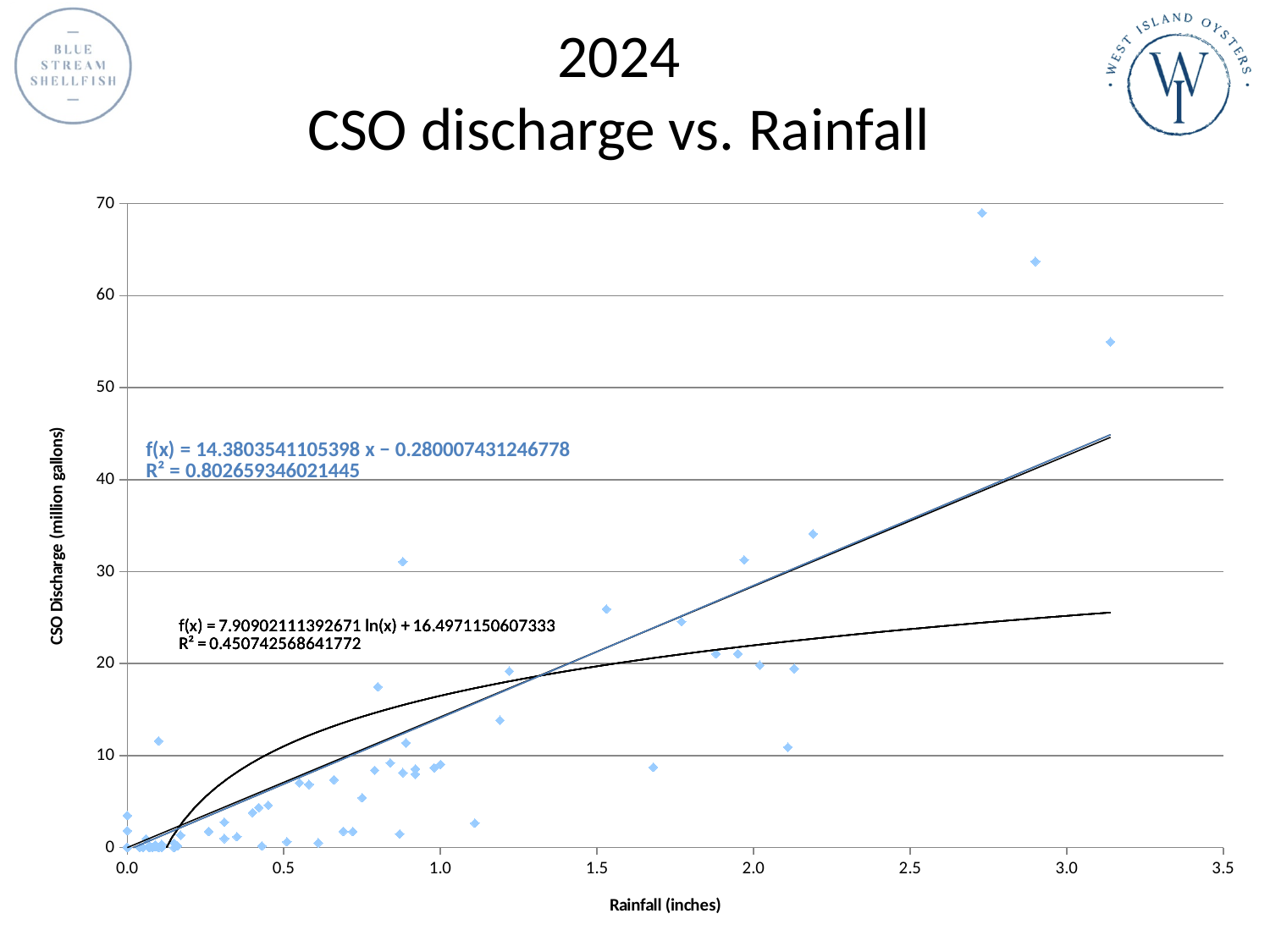
What is the title of the chart on the slide? 2024 CSO discharge vs. Rainfall What kind of chart is shown on the slide? Scatter chart Does CSO discharge generally rise or fall as rainfall increases along the x axis? Rise What is the R² value printed for the logarithmic trendline (black equation)? 0.450742568641772 Is the highest plotted CSO discharge value greater or less than 60? greater Is the CSO discharge for the point at about 2.2 inches of rainfall greater or less than 30? greater What is the slope coefficient in the linear trendline equation f(x) = ... x − 0.280007431246778? 14.3803541105398 What is the R² value printed for the linear trendline (blue equation)? 0.802659346021445 Is the CSO discharge for the point at about 3.1 inches of rainfall greater or less than 50? greater Which trendline has the higher R² value, the linear one or the logarithmic one? Linear What is the label of the x axis? Rainfall (inches) What is the maximum value shown on the y axis? 70